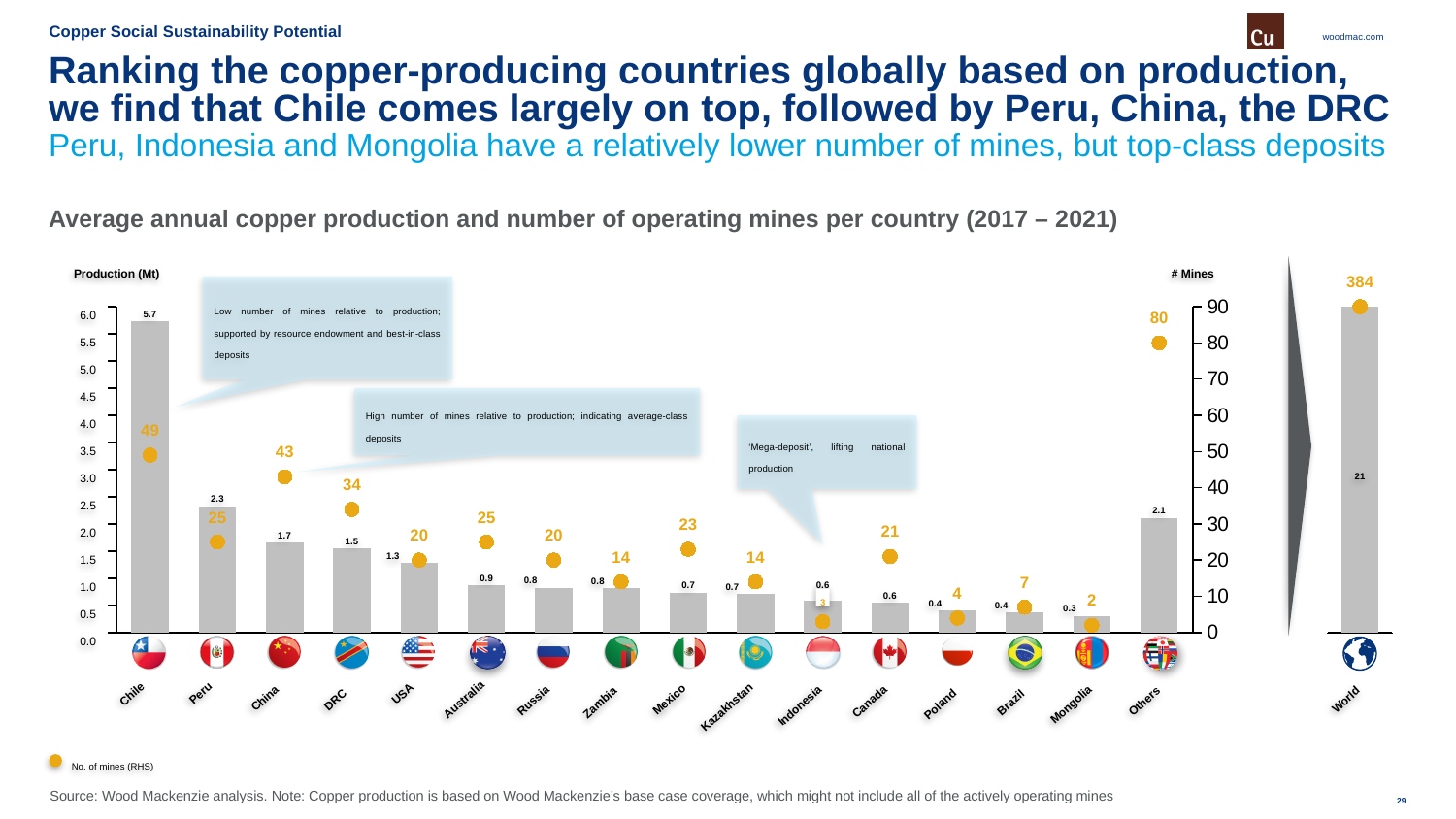
Which country has the highest average annual copper production? Chile How many operating mines are shown for Others? 80 What is the difference between the number of mines for Others and for Chile? 31 Which named country has the fewest operating mines? Mongolia Which has more operating mines, China or the DRC? China Which named country has the lowest average annual copper production? Mongolia What is the legend entry shown below the chart? No. of mines (RHS) How many operating mines are shown for the World? 384 What is the production value shown for the World bar? 21 How many operating mines does China have according to the chart? 43 What is the difference in production between Chile and Peru? 3.4 What is the average annual copper production for Chile? 5.7